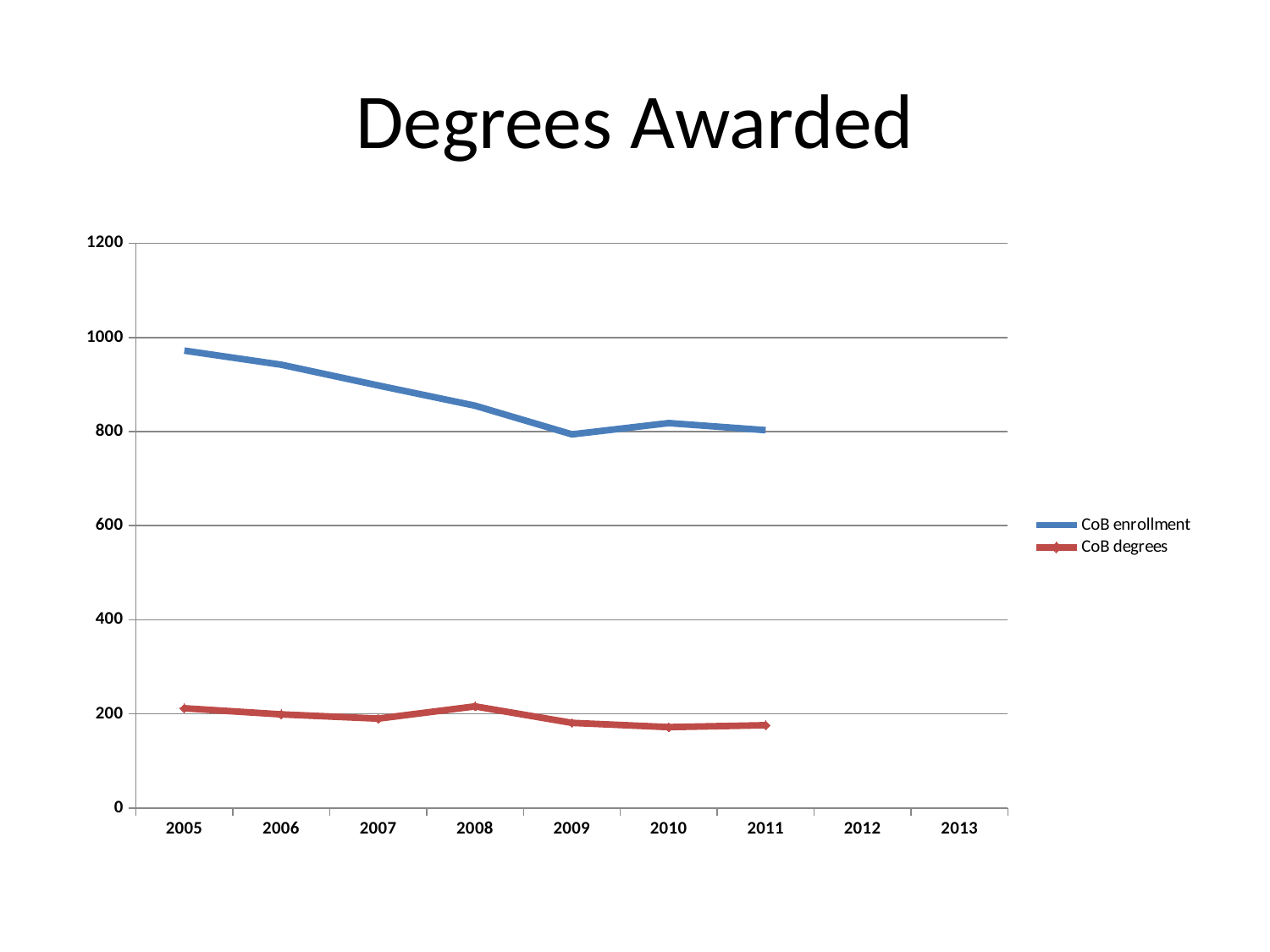
What is the title of the chart? Degrees Awarded Which series is drawn in blue? CoB enrollment Is the CoB enrollment value for 2005 greater or less than 1000? less In which year is CoB enrollment highest? 2005 How many years have a plotted value for CoB enrollment? 7 Is the CoB degrees value for 2010 greater or less than 200? less Which is larger, CoB enrollment in 2005 or CoB enrollment in 2011? 2005 Is the CoB enrollment value for 2008 greater or less than 800? greater How many years are labeled on the x axis? 9 Does CoB enrollment rise or fall from 2005 to 2009? fall How many series does the legend list? 2 What kind of chart is shown on the slide? line chart